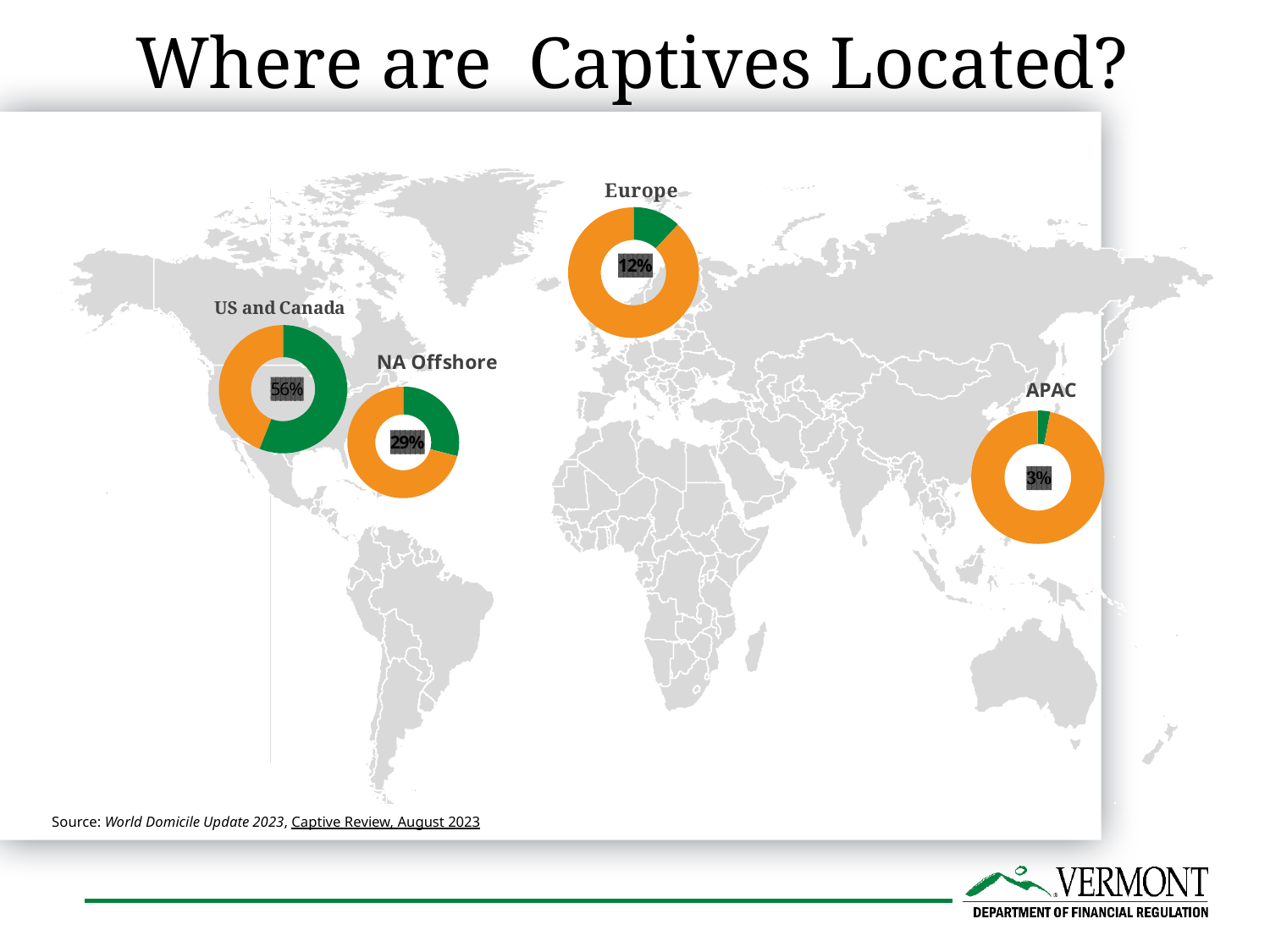
Which has the larger percentage, the Europe donut chart or the NA Offshore donut chart? NA Offshore On the US and Canada donut chart, what colour is the segment representing the 56% share? Green On the APAC donut chart, what percentage is shown in the centre? 3% On the Europe donut chart, what percentage is shown in the centre? 12% On the US and Canada donut chart, what percentage is shown in the centre? 56% How many donut charts are shown on the map? 4 Across the four donut charts on the slide, which region has the highest percentage? US and Canada Across the four donut charts on the slide, which region has the lowest percentage? APAC What kind of chart is used for each region on the slide? Donut (pie) chart What is the difference between the percentage on the Europe donut chart and the percentage on the APAC donut chart? 9% On the NA Offshore donut chart, what percentage is shown in the centre? 29% What is the difference between the percentage on the US and Canada donut chart and the percentage on the NA Offshore donut chart? 27%